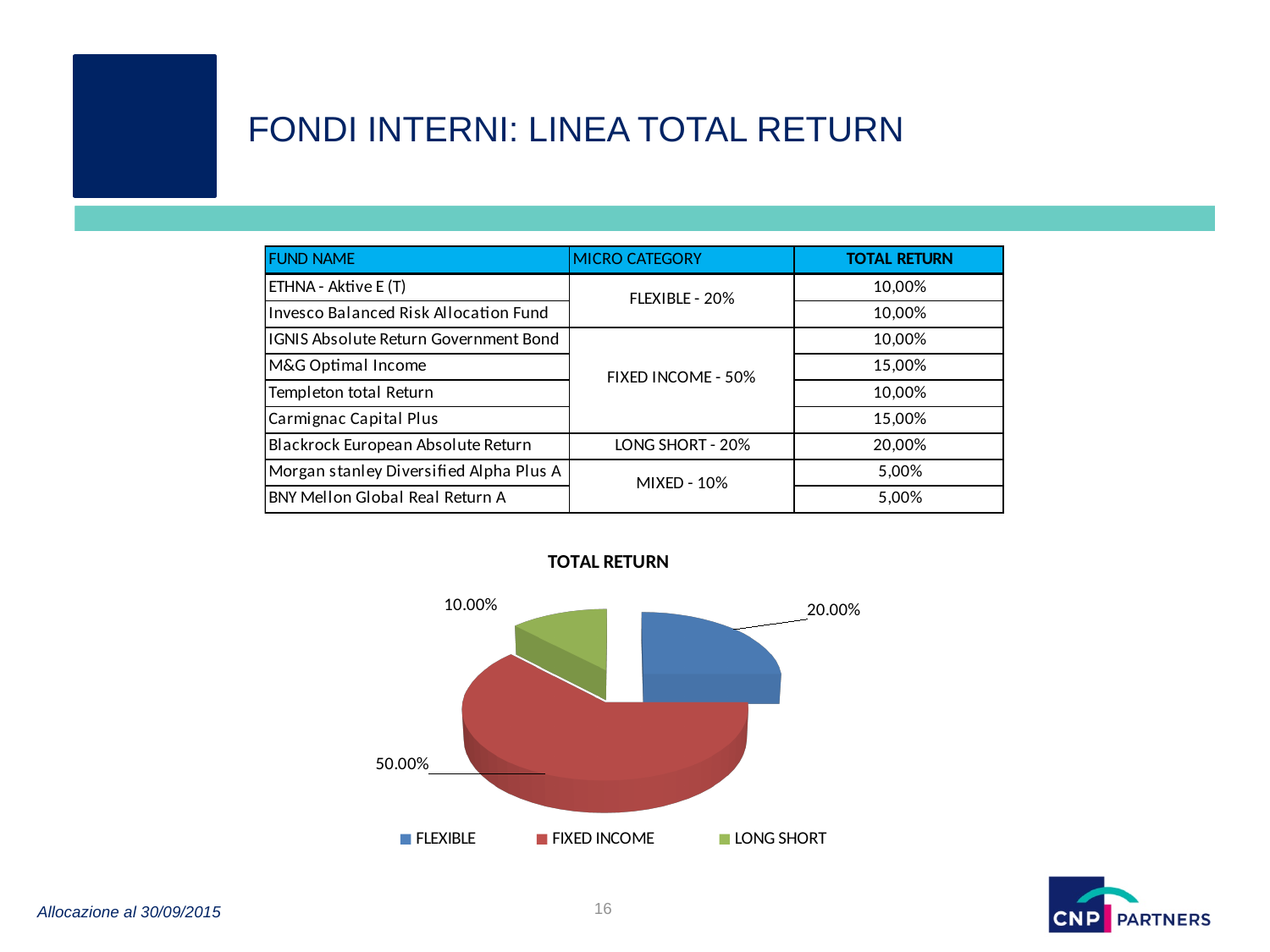
What is the difference between the FIXED INCOME and FLEXIBLE values? 30.00% What value is shown for the FLEXIBLE slice? 20.00% What kind of chart is shown on the slide? pie chart How many slices does the pie chart have? 3 Which category has the smallest slice of the pie? LONG SHORT What is the title of the chart? TOTAL RETURN Which category has the largest slice of the pie? FIXED INCOME What colour is the FIXED INCOME slice? red What value is shown for the LONG SHORT slice? 10.00% How many entries does the chart legend list? 3 Which is larger, the FLEXIBLE slice or the LONG SHORT slice? FLEXIBLE What value is shown for the FIXED INCOME slice? 50.00%